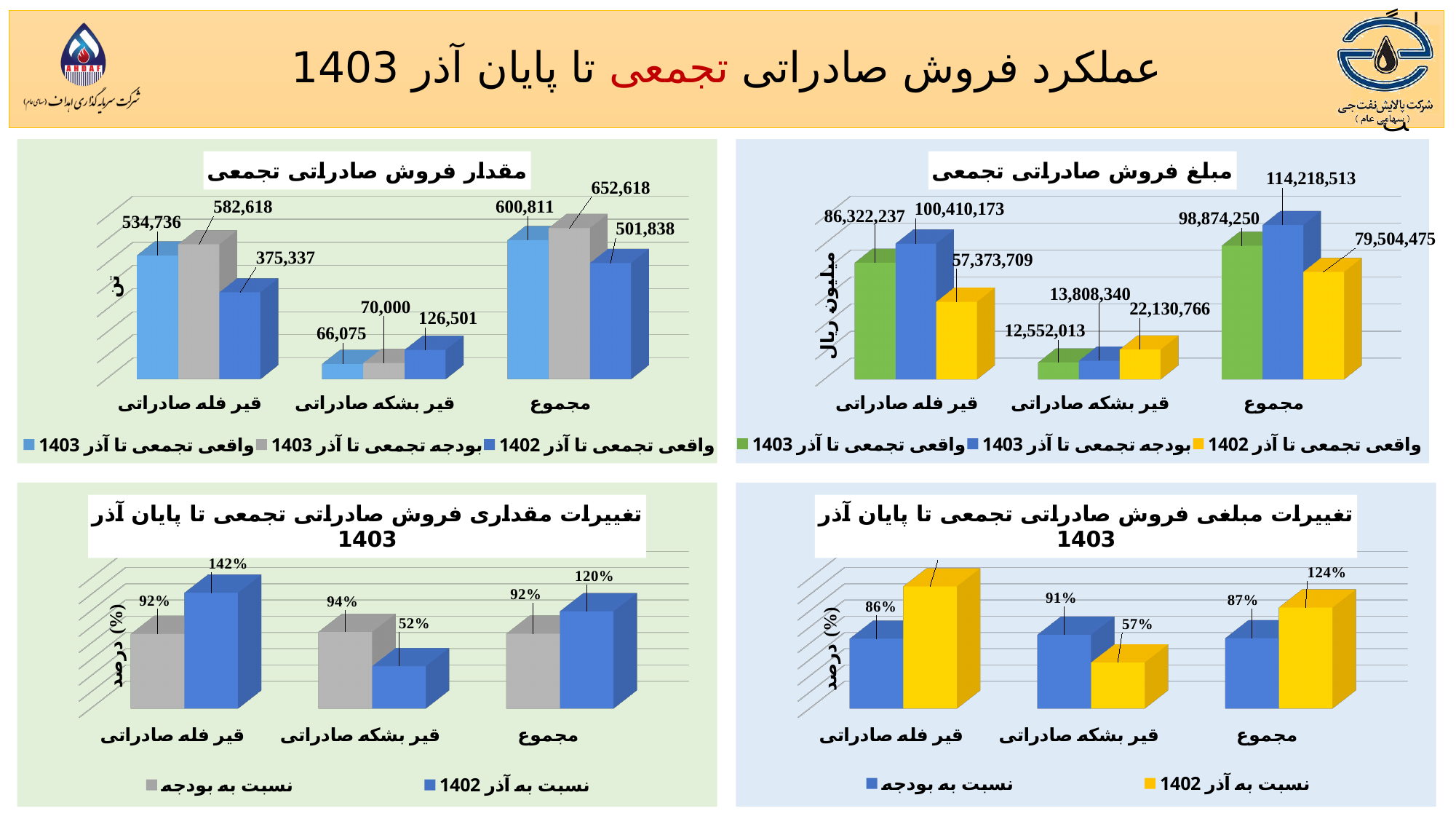
In the bottom-right chart (تغییرات مبلغی فروش صادراتی تجمعی تا پایان آذر 1403), what is the value of نسبت به بودجه for قیر بشکه صادراتی? 91% In the bottom-left chart (تغییرات مقداری فروش صادراتی تجمعی تا پایان آذر 1403), what is the value of نسبت به آذر 1402 for قیر فله صادراتی? 142% In the top-left chart (مقدار فروش صادراتی تجمعی), what is the difference between بودجه تجمعی تا آذر 1403 and واقعی تجمعی تا آذر 1403 for قیر فله صادراتی? 47,882 In the top-right chart (مبلغ فروش صادراتی تجمعی), what is the value of واقعی تجمعی تا آذر 1402 for قیر بشکه صادراتی? 22,130,766 In the top-right chart (مبلغ فروش صادراتی تجمعی), which category has the highest value for بودجه تجمعی تا آذر 1403? مجموع What kind of chart is the bottom-right chart (تغییرات مبلغی فروش صادراتی تجمعی تا پایان آذر 1403)? Bar chart In the top-right chart (مبلغ فروش صادراتی تجمعی), which is larger for قیر فله صادراتی: واقعی تجمعی تا آذر 1403 or واقعی تجمعی تا آذر 1402? واقعی تجمعی تا آذر 1403 In the top-left chart (مقدار فروش صادراتی تجمعی), what is the value of بودجه تجمعی تا آذر 1403 for مجموع? 652,618 In the top-left chart (مقدار فروش صادراتی تجمعی), how many series does the legend list? 3 In the top-right chart (مبلغ فروش صادراتی تجمعی), what unit is shown on the vertical axis? میلیون ریال In the bottom-left chart (تغییرات مقداری فروش صادراتی تجمعی تا پایان آذر 1403), which category has the lowest value for نسبت به آذر 1402? قیر بشکه صادراتی In the top-left chart (مقدار فروش صادراتی تجمعی), what is the value of واقعی تجمعی تا آذر 1403 for قیر فله صادراتی? 534,736